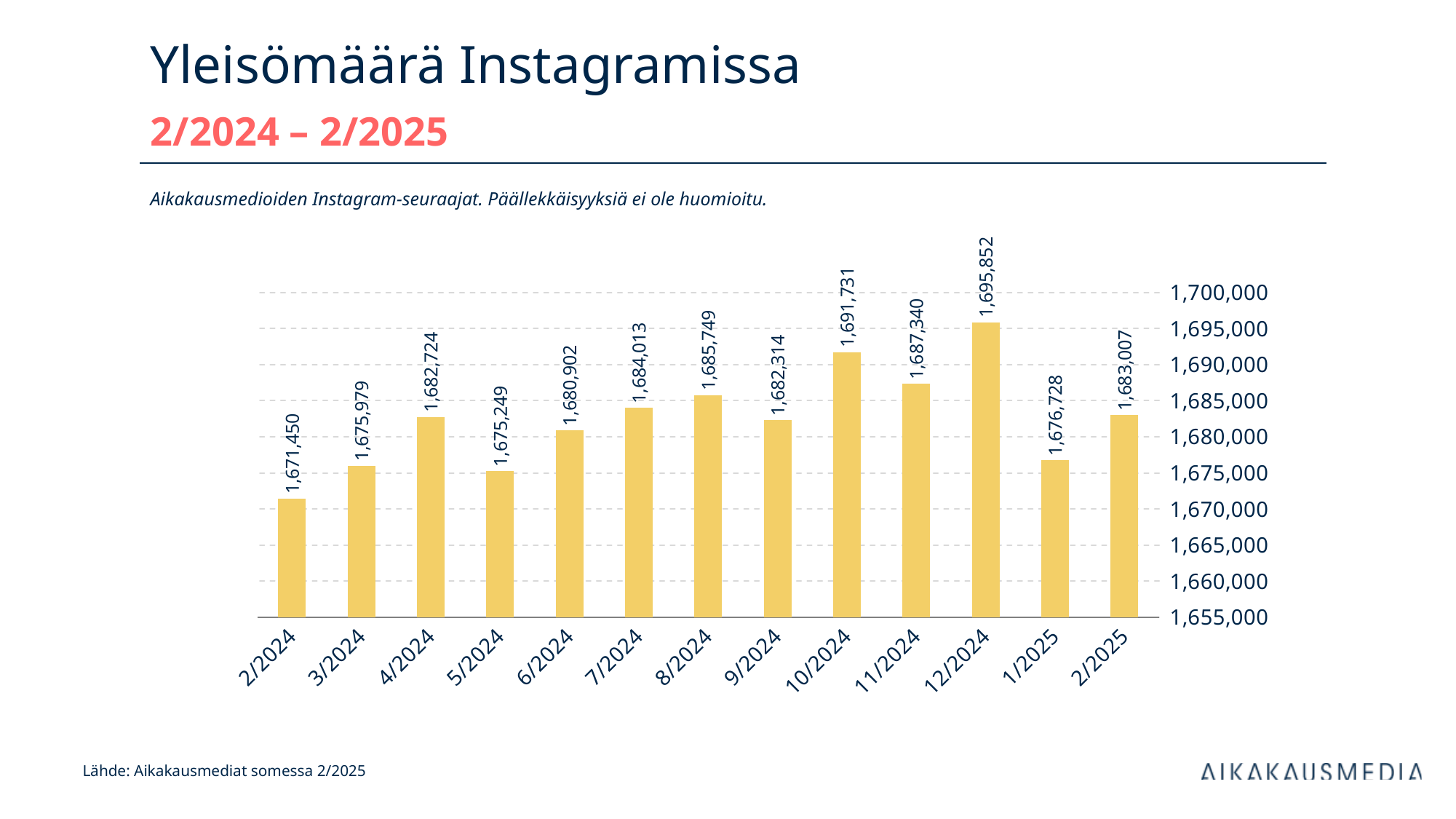
What is the title of the slide? Yleisömäärä Instagramissa What is the value for 2/2024? 1,671,450 What is the value for 10/2024? 1,691,731 How many months are shown on the x axis? 13 What kind of chart is shown on the slide? Bar chart Which month has the lowest value? 2/2024 What is the difference between the values for 2/2025 and 1/2025? 6,279 What is the value for 12/2024? 1,695,852 What is the difference between the values for 12/2024 and 2/2024? 24,402 Which is larger, the value for 10/2024 or the value for 11/2024? 10/2024 What is the value for 1/2025? 1,676,728 Which month has the highest value? 12/2024